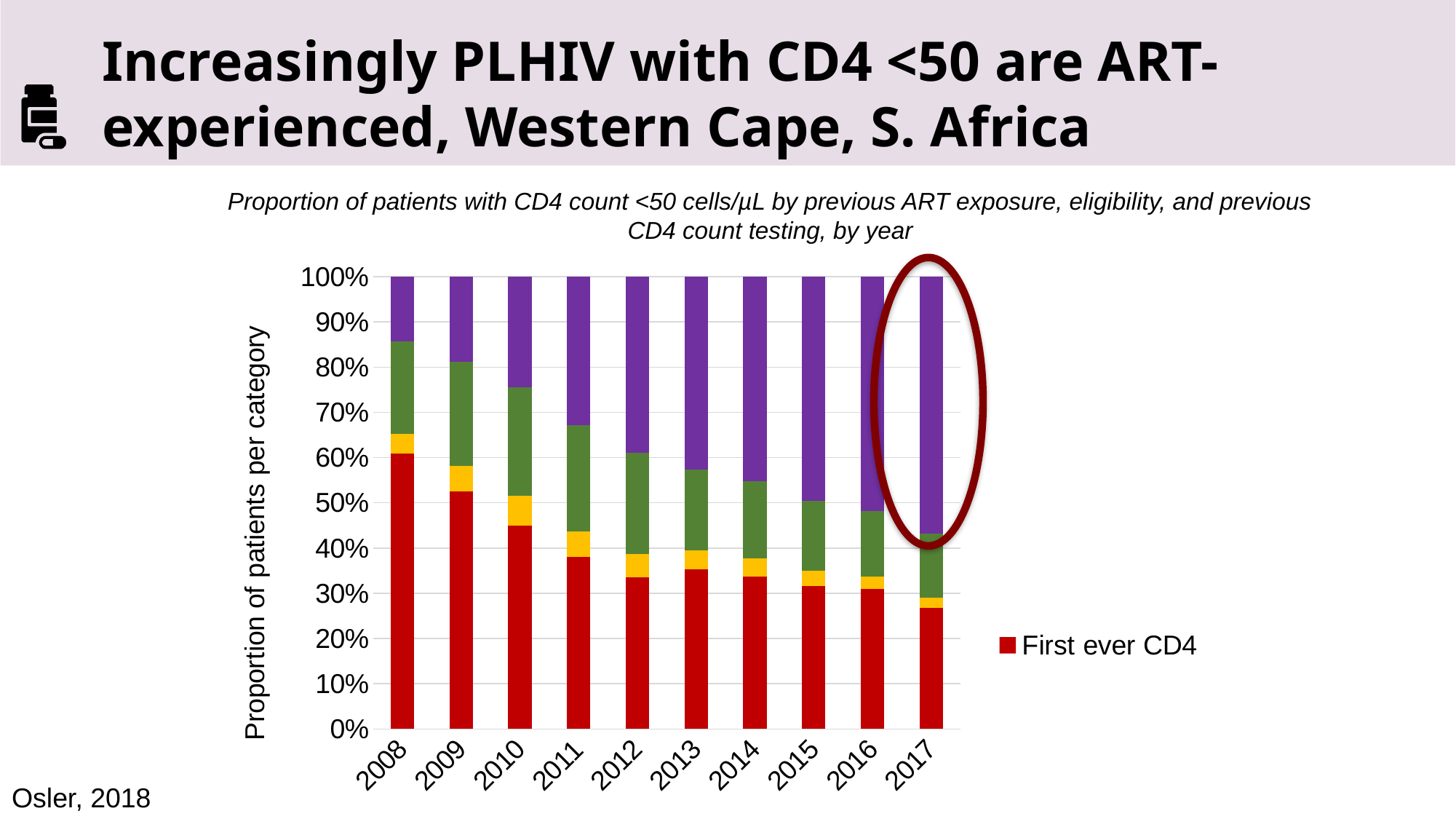
How many series does the chart's legend list? 1 Is the 'First ever CD4' proportion for 2012 greater or less than 40%? less Is the 'First ever CD4' proportion for 2008 greater or less than 50%? greater Which year has the lowest proportion for 'First ever CD4'? 2017 Which year has a larger 'First ever CD4' proportion, 2008 or 2017? 2008 Is the 'First ever CD4' proportion for 2017 greater or less than 30%? less What kind of chart is shown on the slide? Stacked bar chart Which series is named in the chart's legend? First ever CD4 What colour represents the 'First ever CD4' series in the chart? Red Does the 'First ever CD4' proportion generally rise or fall from 2008 to 2017? Fall How many years are shown along the x axis of the chart? 10 Which year has the highest proportion for 'First ever CD4'? 2008